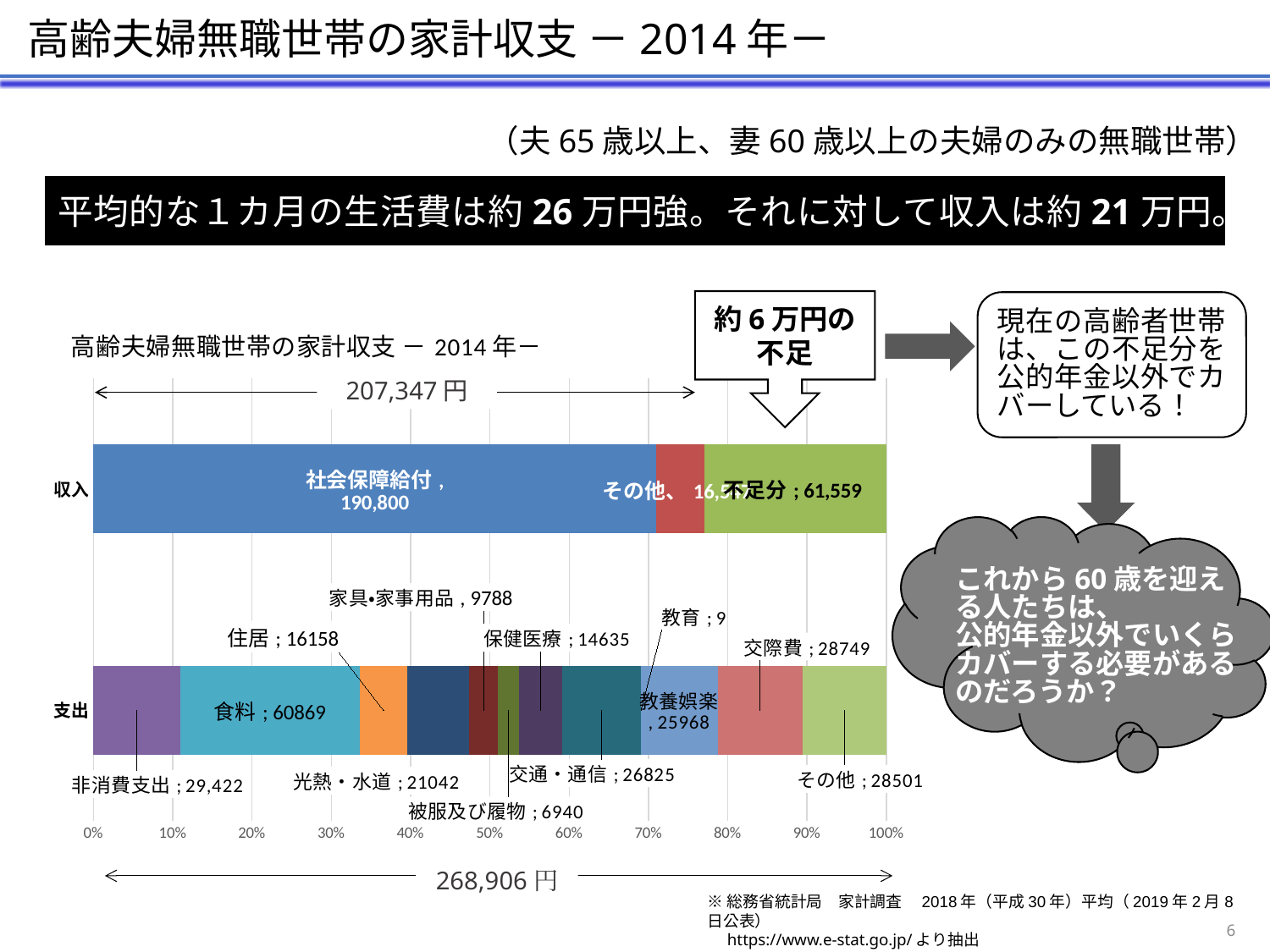
Which category in the 支出 bar has the largest value? 食料 What type of chart is shown on the slide? Stacked bar chart What is the value of 社会保障給付 in the 収入 bar? 190,800 What is the value of 住居 in the 支出 bar? 16158 Which is larger in the 支出 bar, 交通・通信 or 教養娯楽? 交通・通信 What is the total of the 支出 bar as printed on the slide? 268,906 円 What is the value of 食料 in the 支出 bar? 60869 What is the value of 不足分 in the 収入 bar? 61,559 How many bars does the chart contain? 2 What is the value of 保健医療 in the 支出 bar? 14635 What is the title of the chart? 高齢夫婦無職世帯の家計収支 － 2014 年－ What is the difference between 食料 and 非消費支出 in the 支出 bar? 31447